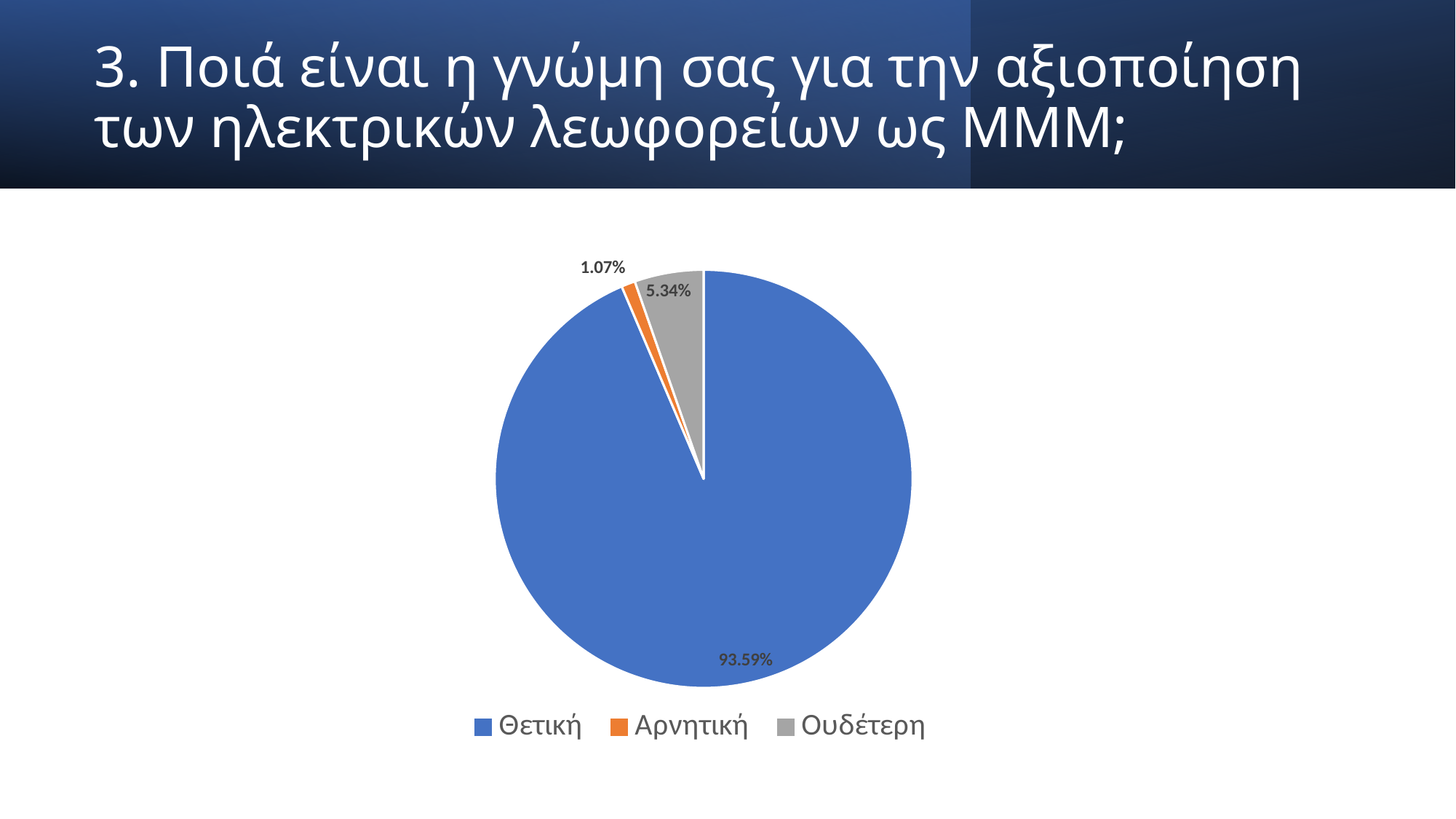
What percentage of the pie is Ουδέτερη? 5.34% What is the difference in percentage points between the Θετική and Ουδέτερη slices? 88.25% How many entries does the legend list? 3 Which category has the largest share of the pie? Θετική Which category has the smallest share of the pie? Αρνητική What kind of chart is shown on the slide? pie chart What percentage of the pie is Αρνητική? 1.07% What percentage of the pie is Θετική? 93.59% What colour is the Ουδέτερη slice? grey What is the difference in percentage points between the Ουδέτερη and Αρνητική slices? 4.27% How many slices does the pie chart have? 3 Which is larger, the share for Ουδέτερη or the share for Αρνητική? Ουδέτερη